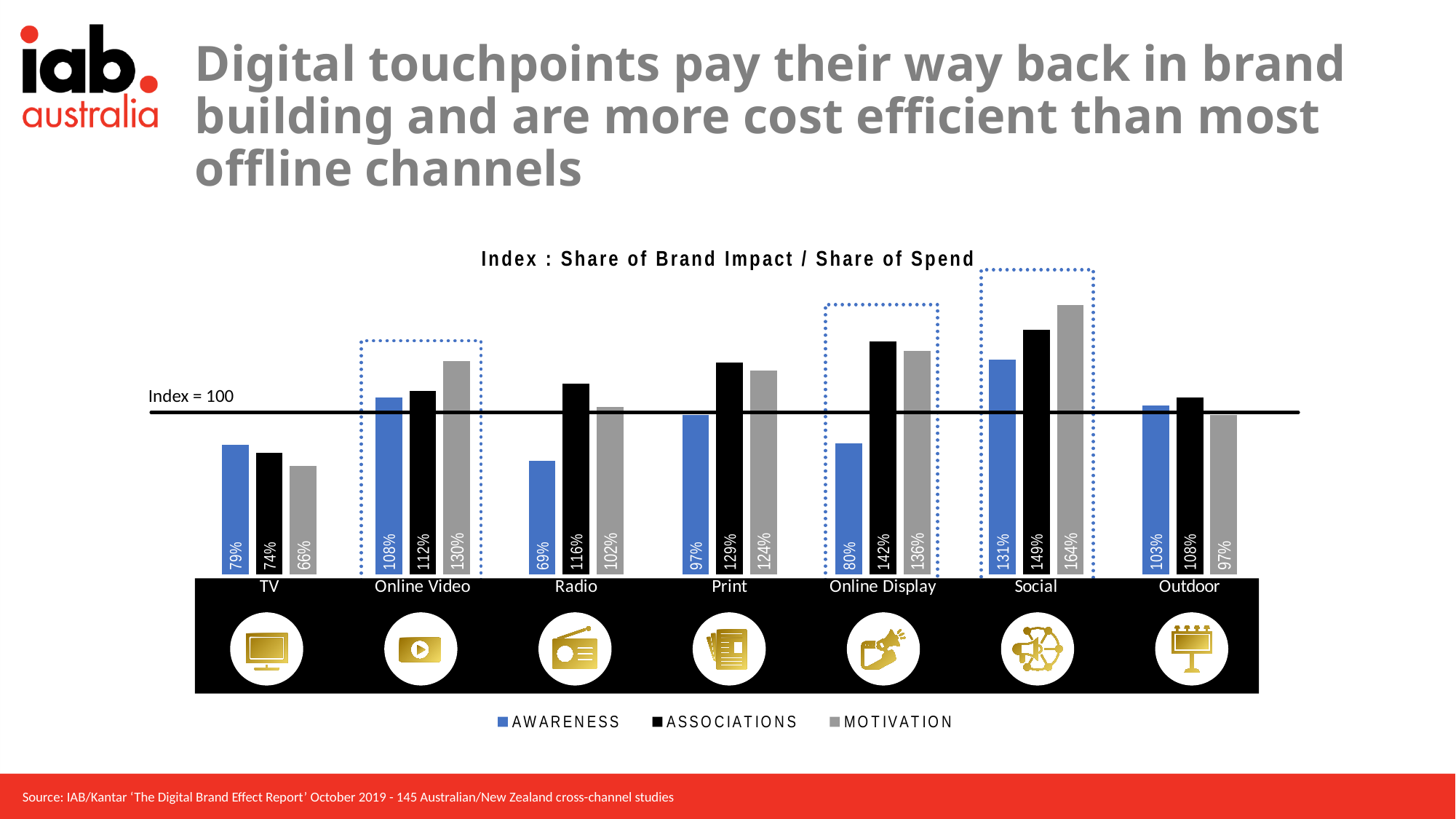
What is the title of the chart? Index : Share of Brand Impact / Share of Spend Which channel has the lowest Awareness index value? Radio What is the Associations index value for Radio? 116% What kind of chart is shown on the slide? bar chart Which channel has the highest Associations index value? Social What is the Awareness index value for Online Video? 108% How many series does the legend list? 3 How many channels are shown on the x axis of the chart? 7 What is the difference between the Motivation index for Online Display and the Motivation index for TV? 70% What is the Motivation index value for Social? 164% Which is larger, the Awareness index for Print or the Awareness index for Online Display? Print Is the Motivation index value for Outdoor greater or less than 100? less